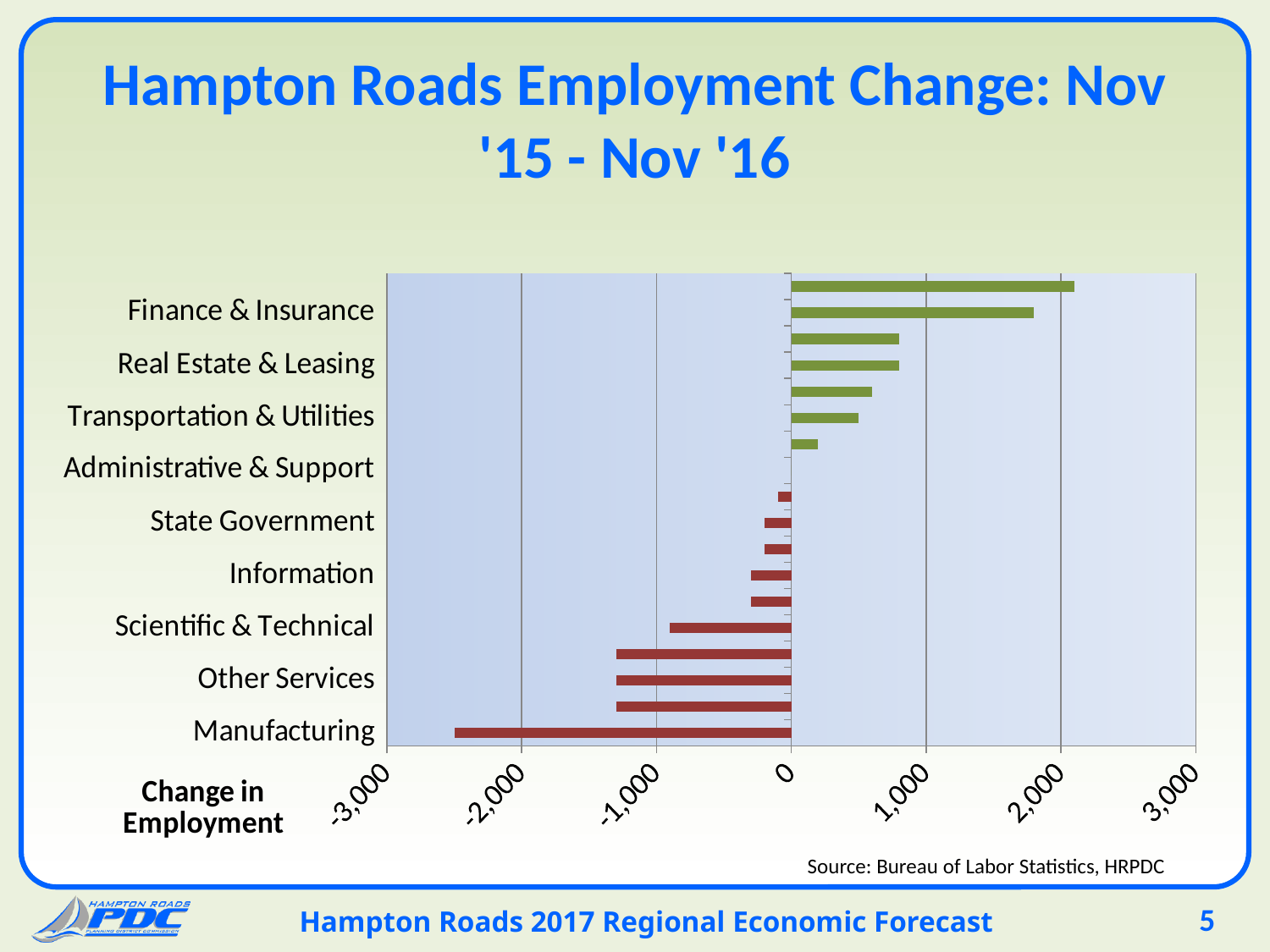
Is the value for Transportation & Utilities greater or less than 0? greater Which labeled category has the lowest employment change? Manufacturing How many category labels are shown on the vertical axis? 9 Is the value for Finance & Insurance greater or less than 1,000? greater What is the label of the horizontal axis? Change in Employment Is the value for Real Estate & Leasing greater or less than 1,000? less What kind of chart is shown on the slide? bar chart Which has the larger employment change, Finance & Insurance or Real Estate & Leasing? Finance & Insurance Which has the larger employment change, Manufacturing or Other Services? Other Services